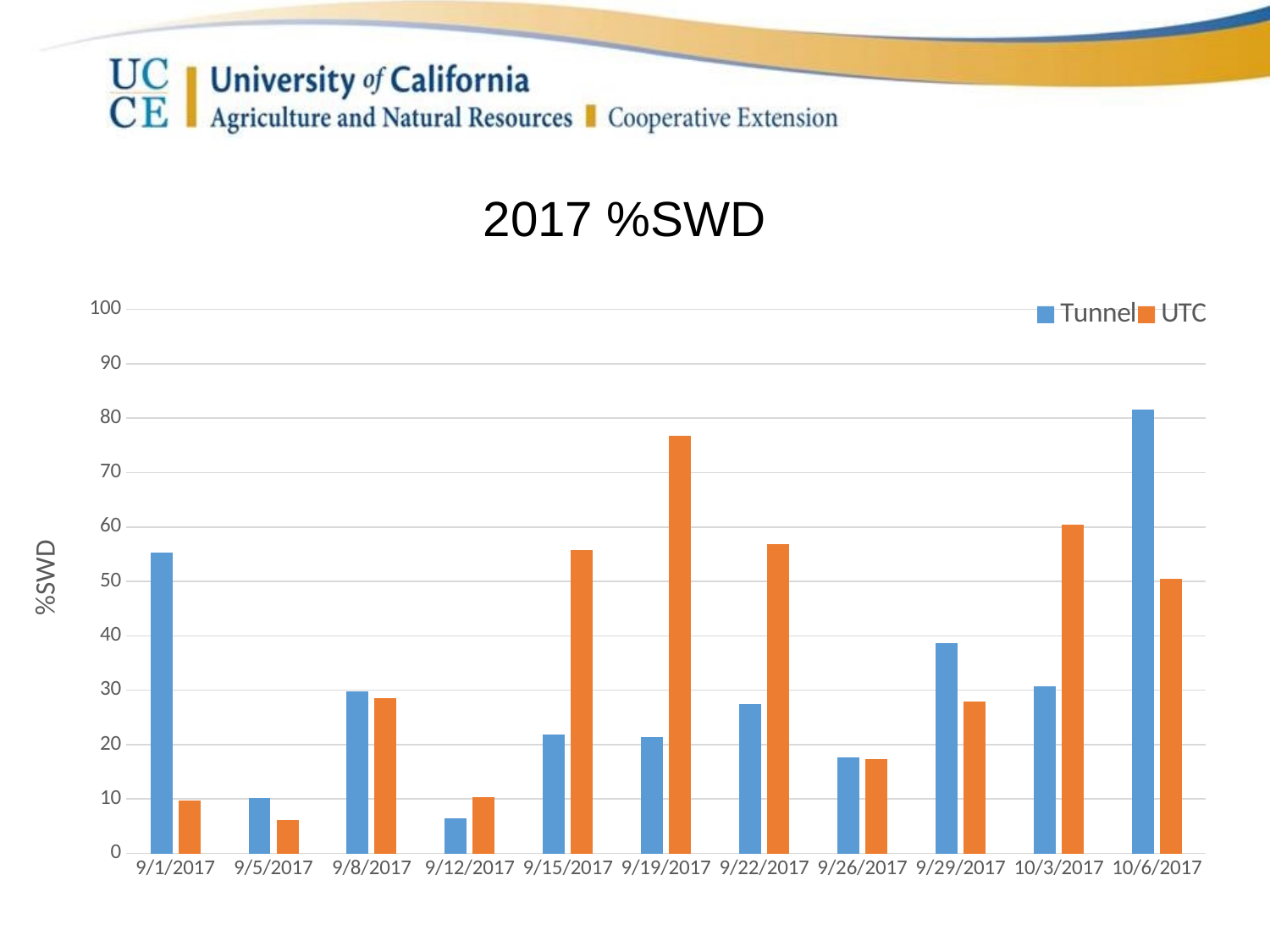
On which date is the Tunnel value highest? 10/6/2017 Which is larger on 9/29/2017, the Tunnel value or the UTC value? Tunnel On which date is the Tunnel value lowest? 9/12/2017 Is the Tunnel value for 9/1/2017 greater or less than 50? greater How many dates are shown on the x axis? 11 How many series does the legend list? 2 What kind of chart is shown on the slide? bar chart Is the UTC value for 9/19/2017 greater or less than 70? greater On which date is the UTC value highest? 9/19/2017 On which date is the UTC value lowest? 9/5/2017 Which is larger on 9/15/2017, the Tunnel value or the UTC value? UTC